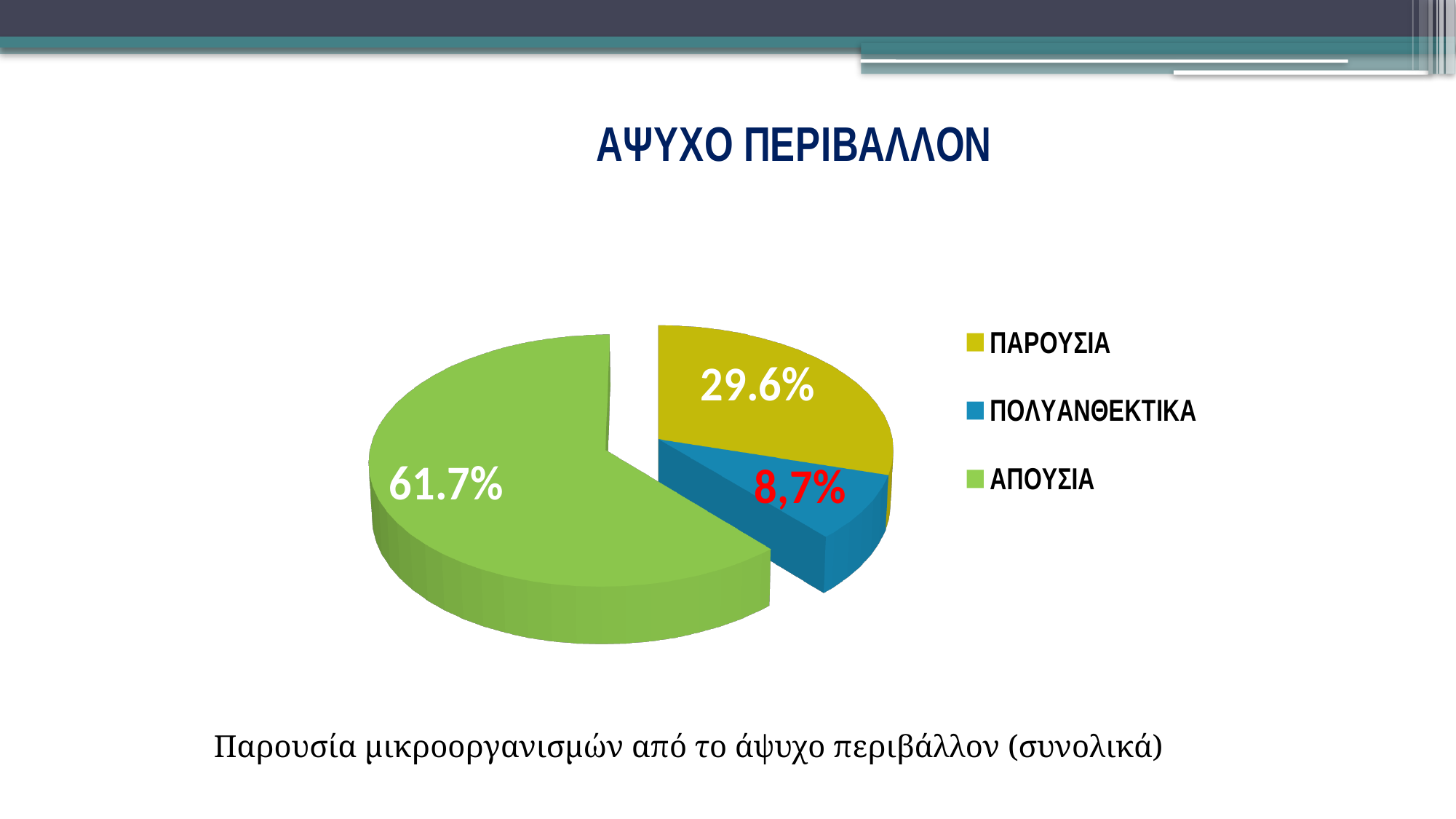
What is the value for ΠΑΡΟΥΣΙΑ? 29.6% Which category has the smallest slice of the pie? ΠΟΛΥΑΝΘΕΚΤΙΚΑ What is the value for ΑΠΟΥΣΙΑ? 61.7% What is the title of the slide above the chart? ΑΨΥΧΟ ΠΕΡΙΒΑΛΛΟΝ Which category has the largest slice of the pie? ΑΠΟΥΣΙΑ How many categories does the pie chart have? 3 What kind of chart is shown on the slide? pie chart What is the difference between the values for ΑΠΟΥΣΙΑ and ΠΑΡΟΥΣΙΑ? 32.1% What is the value for ΠΟΛΥΑΝΘΕΚΤΙΚΑ? 8,7% What colour is the slice for ΑΠΟΥΣΙΑ? green Which is larger, the value for ΠΑΡΟΥΣΙΑ or the value for ΠΟΛΥΑΝΘΕΚΤΙΚΑ? ΠΑΡΟΥΣΙΑ What is the difference between the values for ΠΑΡΟΥΣΙΑ and ΠΟΛΥΑΝΘΕΚΤΙΚΑ? 20.9%